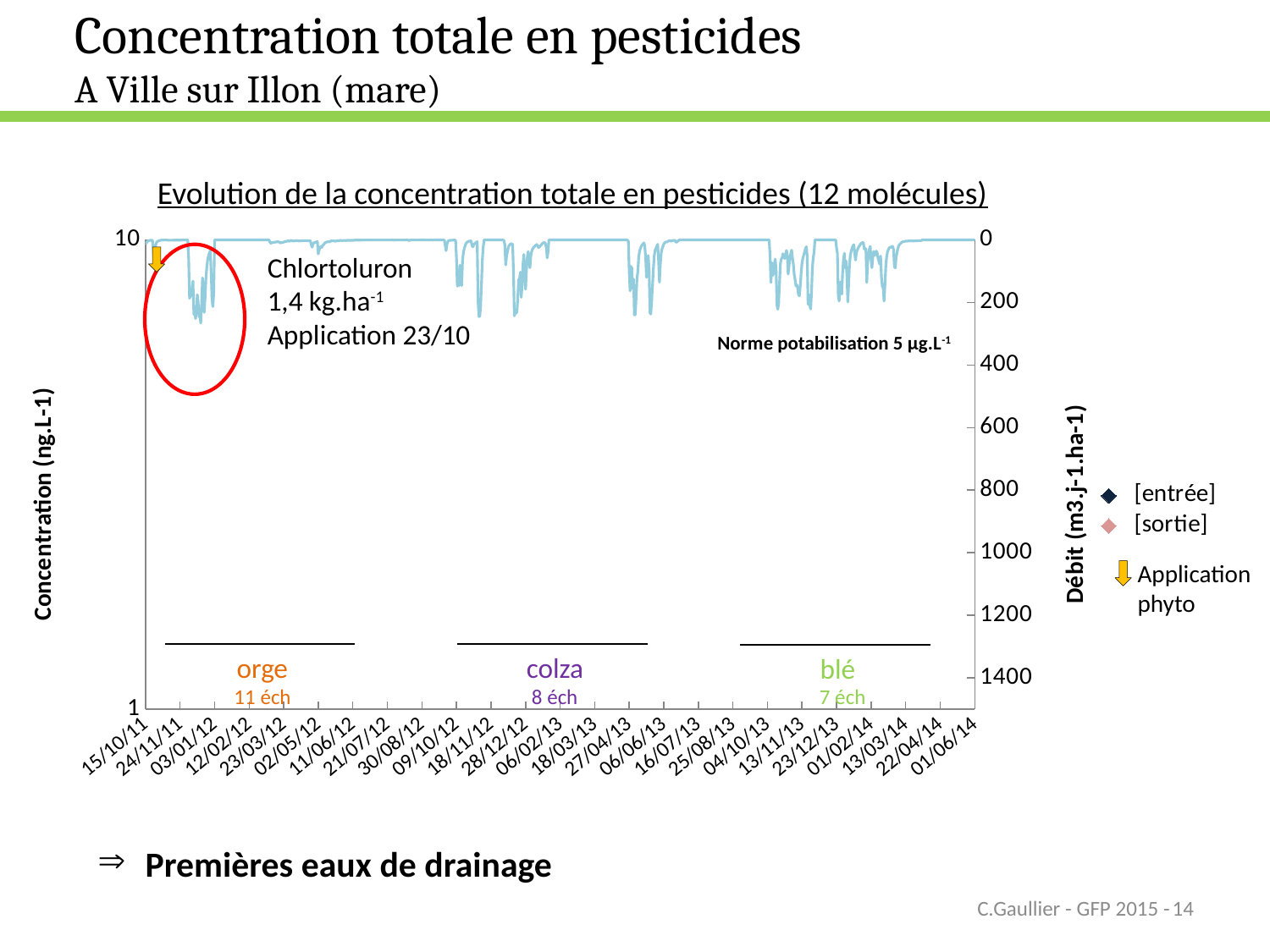
How many crop periods are labelled along the bottom of the chart? 3 How many samples (éch) are indicated for the blé period? 7 éch What kind of chart is shown on the slide? line chart How many series does the chart legend list? 2 On what date was the Chlortoluron application made according to the chart annotation? 23/10 Which crop period has the highest number of samples? orge Is the largest débit peak (the dip near 03/01/12 on the right-hand axis) greater or less than 400? less How many samples (éch) are indicated for the orge period? 11 éch How many samples (éch) are indicated for the colza period? 8 éch What is the title of the chart? Evolution de la concentration totale en pesticides (12 molécules) What are the two entries in the chart legend? [entrée] and [sortie] Which crop period has the lowest number of samples? blé